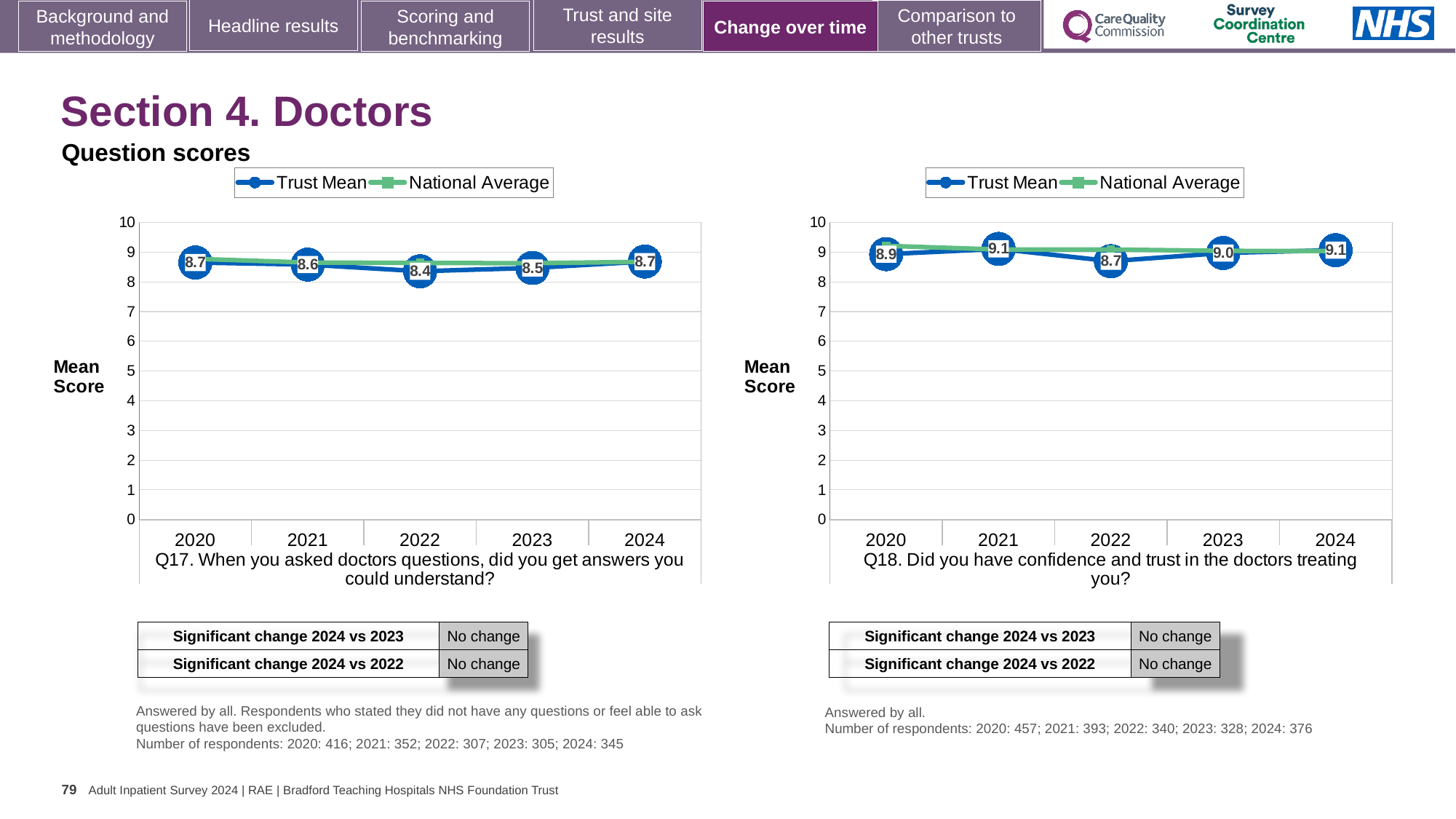
What type of chart is used for Q17? line chart In the Q17 chart, is the Trust Mean score for 2021 higher or lower than for 2022? higher In the Q17 chart, which year has the lowest Trust Mean score? 2022 In the Q18 chart, what is the Trust Mean score for 2020? 8.9 In the Q18 chart, which year has the lowest Trust Mean score? 2022 How many series does the legend of the Q18 chart list? 2 How many years are plotted on the x axis of the Q17 chart? 5 In the Q18 chart, is the Trust Mean value for 2021 greater or less than 8? greater In the Q17 chart, what is the Trust Mean score for 2022? 8.4 In the Q18 chart, what is the difference between the Trust Mean scores for 2024 and 2022? 0.4 In the Q18 chart, what is the Trust Mean score for 2023? 9.0 In the Q17 chart, what is the Trust Mean score for 2024? 8.7